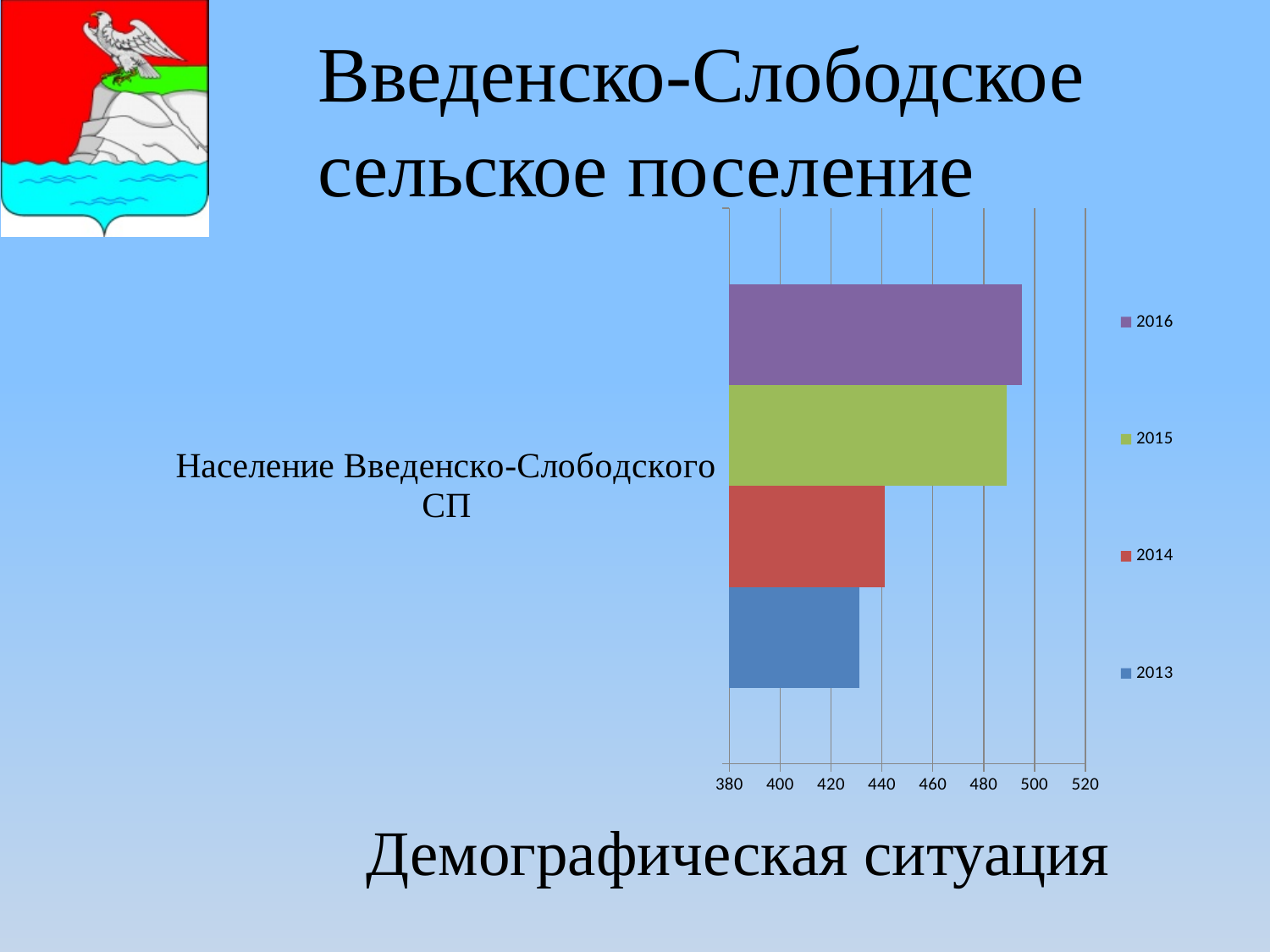
Is the value for 2016 greater or less than 500? less What colour is the bar for 2014? red Is the value for 2013 greater or less than 440? less Is the value for 2013 greater or less than 420? greater How many series does the legend list? 4 What kind of chart is shown on the slide? bar chart Which year has the lowest population value in the chart? 2013 Which year has the highest population value in the chart? 2016 Do the population values rise or fall from 2013 to 2016? rise Which is larger, the value for 2015 or the value for 2013? 2015